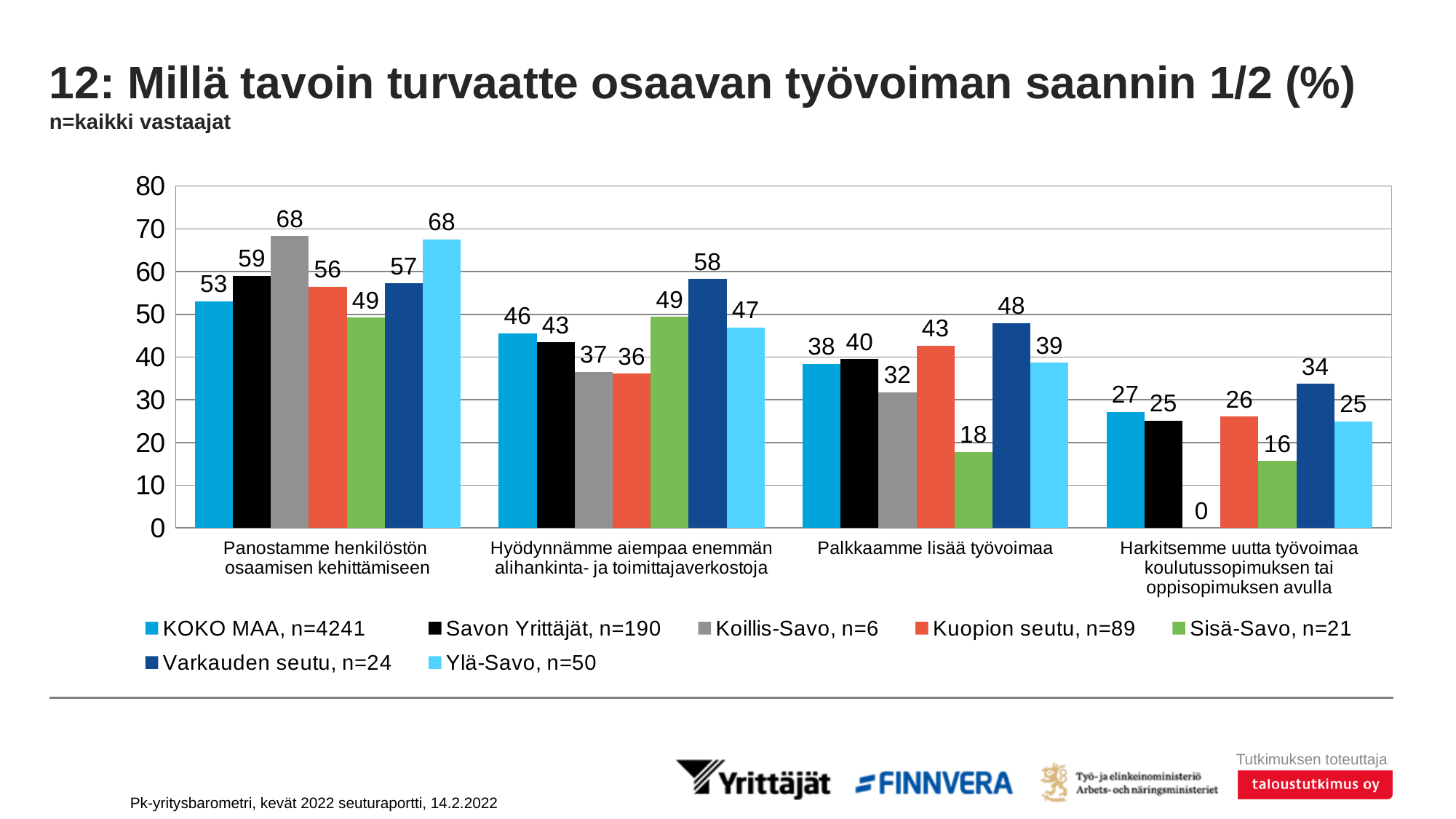
How many series does the legend list? 7 Do the values for KOKO MAA, n=4241 rise or fall across the categories from left to right? Fall What is the difference between the Varkauden seutu, n=24 value and the Sisä-Savo, n=21 value in the category "Harkitsemme uutta työvoimaa koulutussopimuksen tai oppisopimuksen avulla"? 18 In the category "Panostamme henkilöstön osaamisen kehittämiseen", which is larger: the value for Savon Yrittäjät, n=190 or the value for Kuopion seutu, n=89? Savon Yrittäjät, n=190 What is the value for Sisä-Savo, n=21 in the category "Palkkaamme lisää työvoimaa"? 18 What is the value for Koillis-Savo, n=6 in the category "Harkitsemme uutta työvoimaa koulutussopimuksen tai oppisopimuksen avulla"? 0 What is the value for Koillis-Savo, n=6 in the category "Panostamme henkilöstön osaamisen kehittämiseen"? 68 What is the value for Varkauden seutu, n=24 in the category "Hyödynnämme aiempaa enemmän alihankinta- ja toimittajaverkostoja"? 58 Which series has the lowest value in the category "Hyödynnämme aiempaa enemmän alihankinta- ja toimittajaverkostoja"? Kuopion seutu, n=89 How many categories are shown on the x axis of the chart? 4 Which series has the highest value in the category "Palkkaamme lisää työvoimaa"? Varkauden seutu, n=24 What kind of chart is shown on the slide? Bar chart